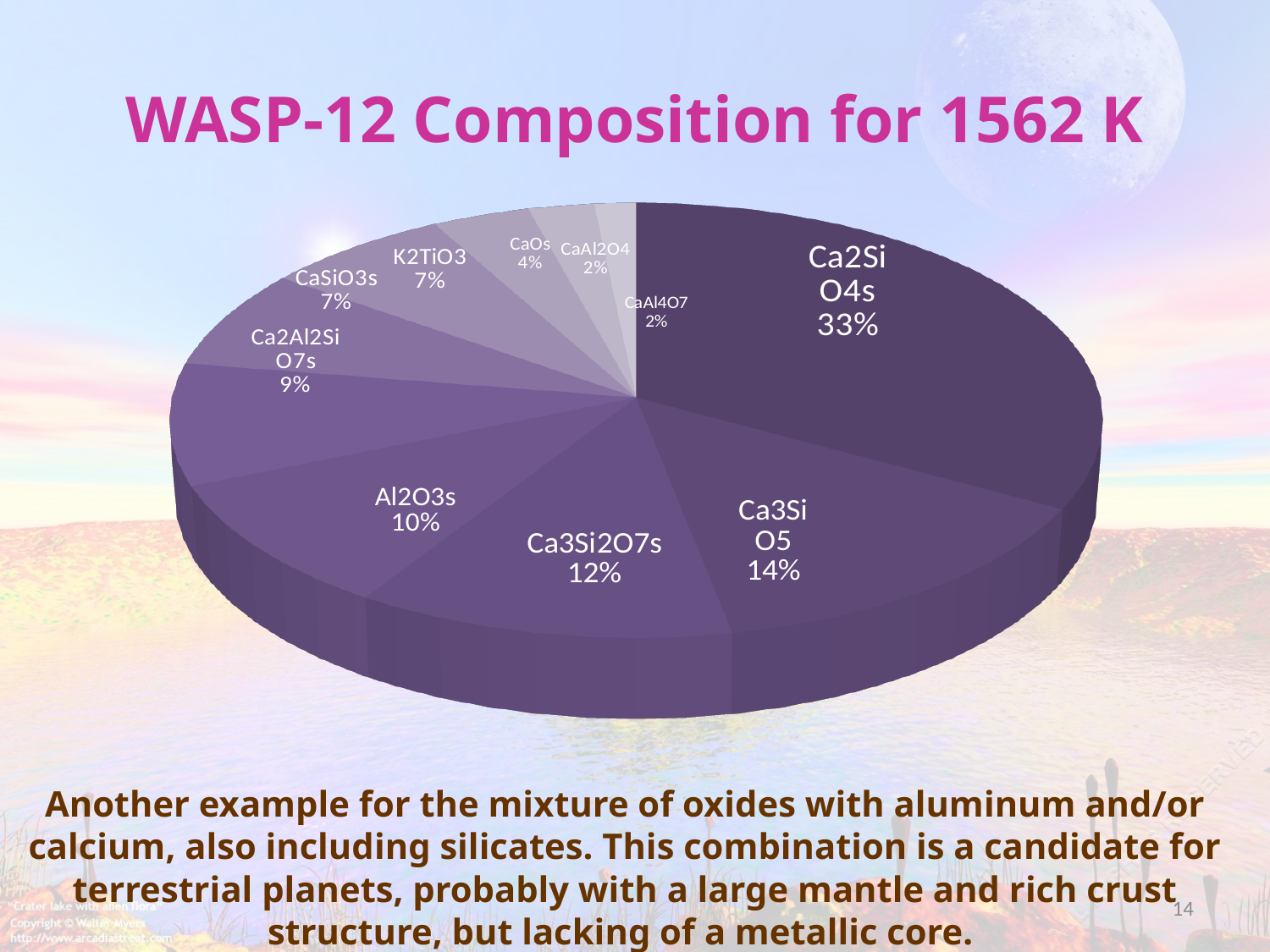
What share of the pie does Ca2SiO4s represent? 33% What type of chart is shown on the slide? Pie chart Which component has the largest share of the pie? Ca2SiO4s How many slices does the pie chart have? 10 What percentage is shown for CaOs? 4% What is the difference in percentage between Ca2SiO4s and Ca3SiO5? 19% What percentage is shown for Ca2Al2SiO7s? 9% What is the difference in percentage between K2TiO3 and CaAl2O4? 5% What percentage is shown for Ca3SiO5? 14% What percentage is shown for Al2O3s? 10% What is the title of the chart? WASP-12 Composition for 1562 K Which has a larger share, Ca3Si2O7s or Al2O3s? Ca3Si2O7s